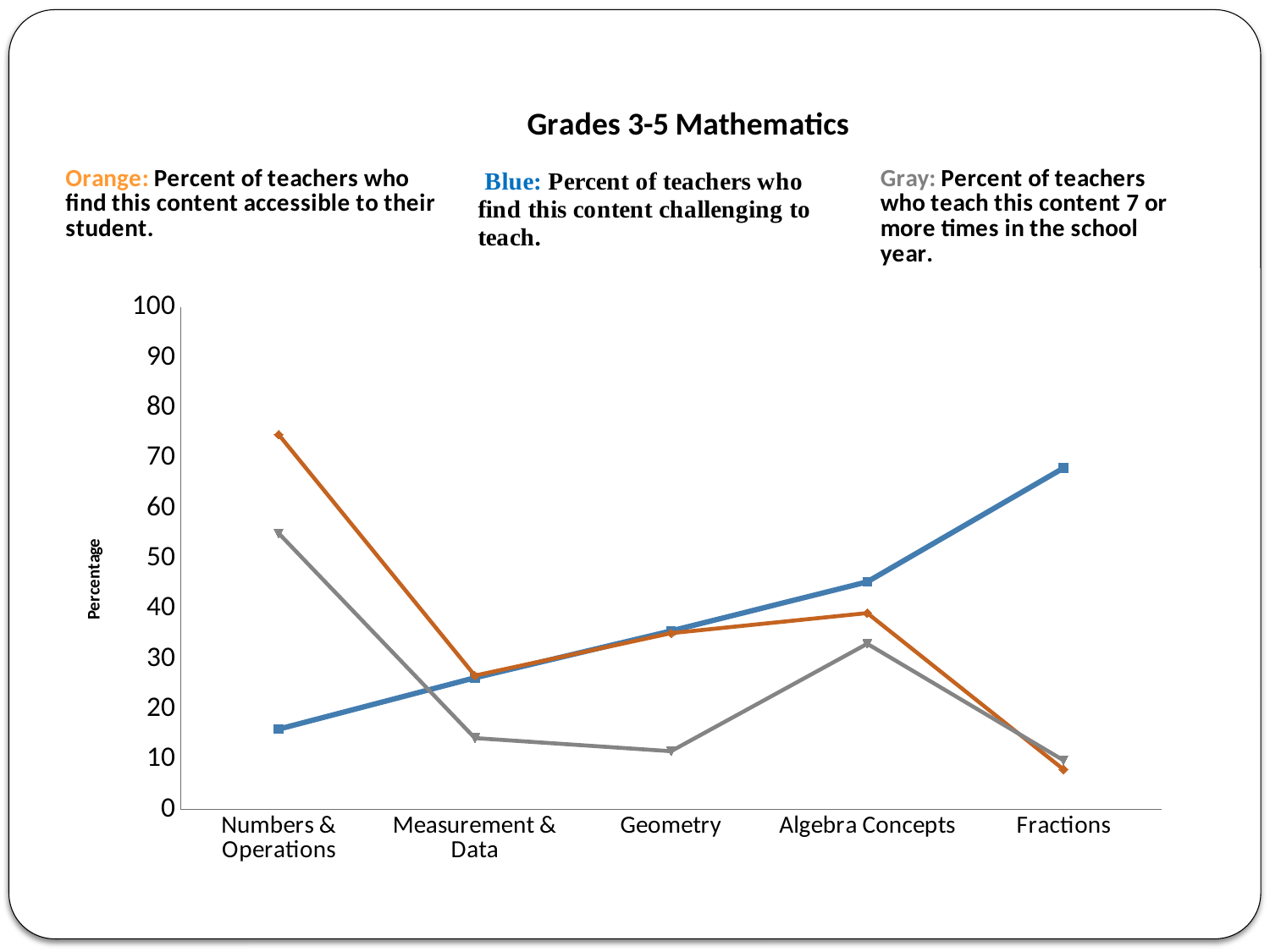
Is the orange value for Numbers & Operations greater or less than 70? greater What kind of chart is shown on the slide? Line chart For which category is the blue line (percent of teachers who find the content challenging to teach) highest? Fractions For which category is the orange line (percent of teachers who find the content accessible) highest? Numbers & Operations At Numbers & Operations, which is larger: the orange value or the gray value? Orange How many content categories are shown on the x axis? 5 For which category is the gray line (percent of teachers who teach the content 7 or more times) highest? Numbers & Operations How many series (colored lines) are plotted on the chart? 3 Is the blue value for Fractions greater or less than 60? greater Does the blue line rise or fall as you move from Numbers & Operations to Fractions along the x axis? Rises For which category is the blue line (percent of teachers who find the content challenging to teach) lowest? Numbers & Operations For which category is the orange line (percent of teachers who find the content accessible) lowest? Fractions